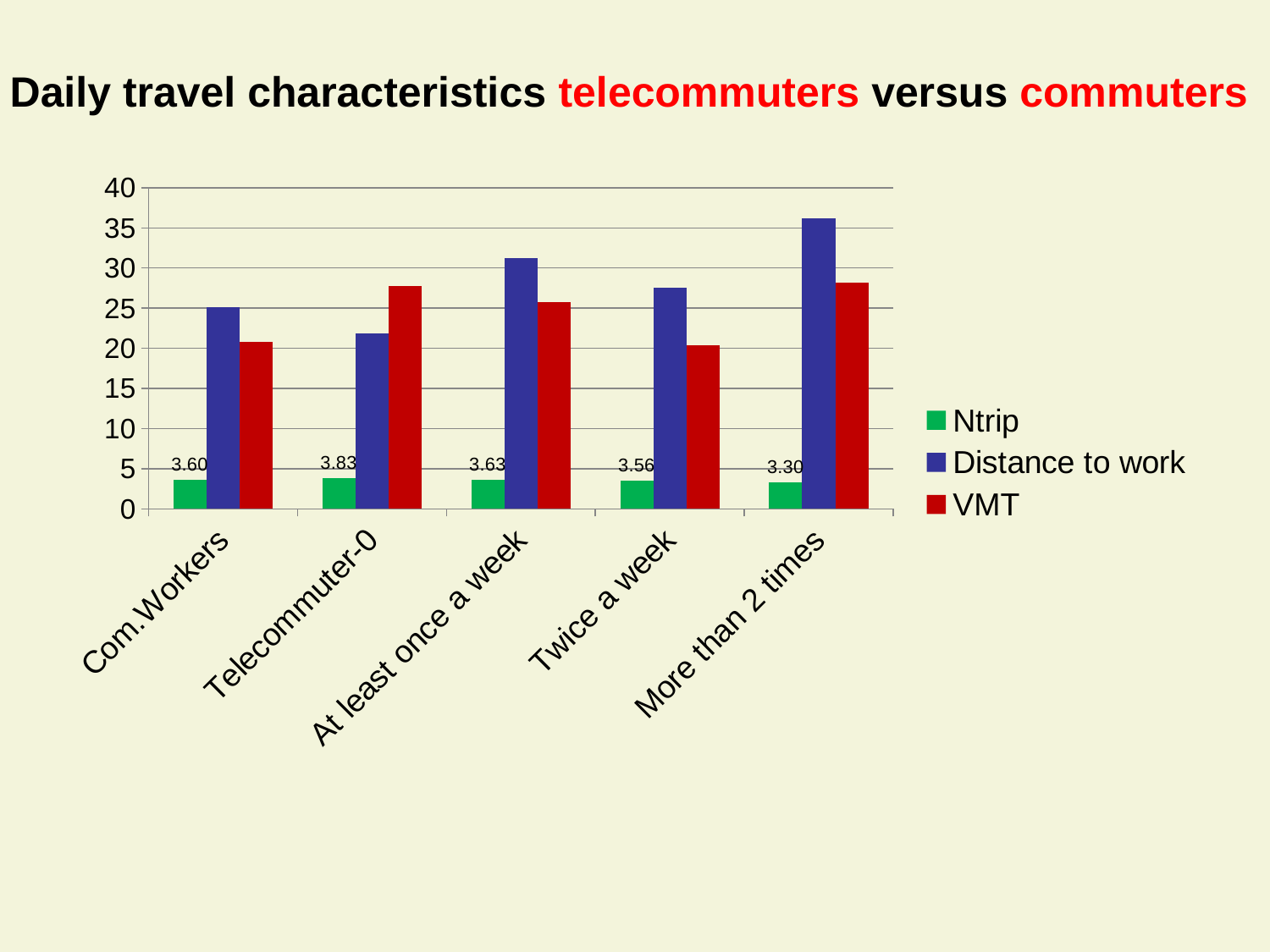
Is the Distance to work value for More than 2 times greater or less than 30? greater Which category has the lowest Ntrip value? More than 2 times How many series does the legend list? 3 Which category has the highest Ntrip value? Telecommuter-0 What is the Ntrip value for Telecommuter-0? 3.83 Which category has the highest Distance to work value? More than 2 times What is the Ntrip value for More than 2 times? 3.30 For Telecommuter-0, which is larger: Distance to work or VMT? VMT What is the Ntrip value for Com.Workers? 3.60 Is the VMT value for Com.Workers greater or less than 25? less How many categories are shown on the x axis? 5 What is the difference between the Ntrip values for Telecommuter-0 and More than 2 times? 0.53